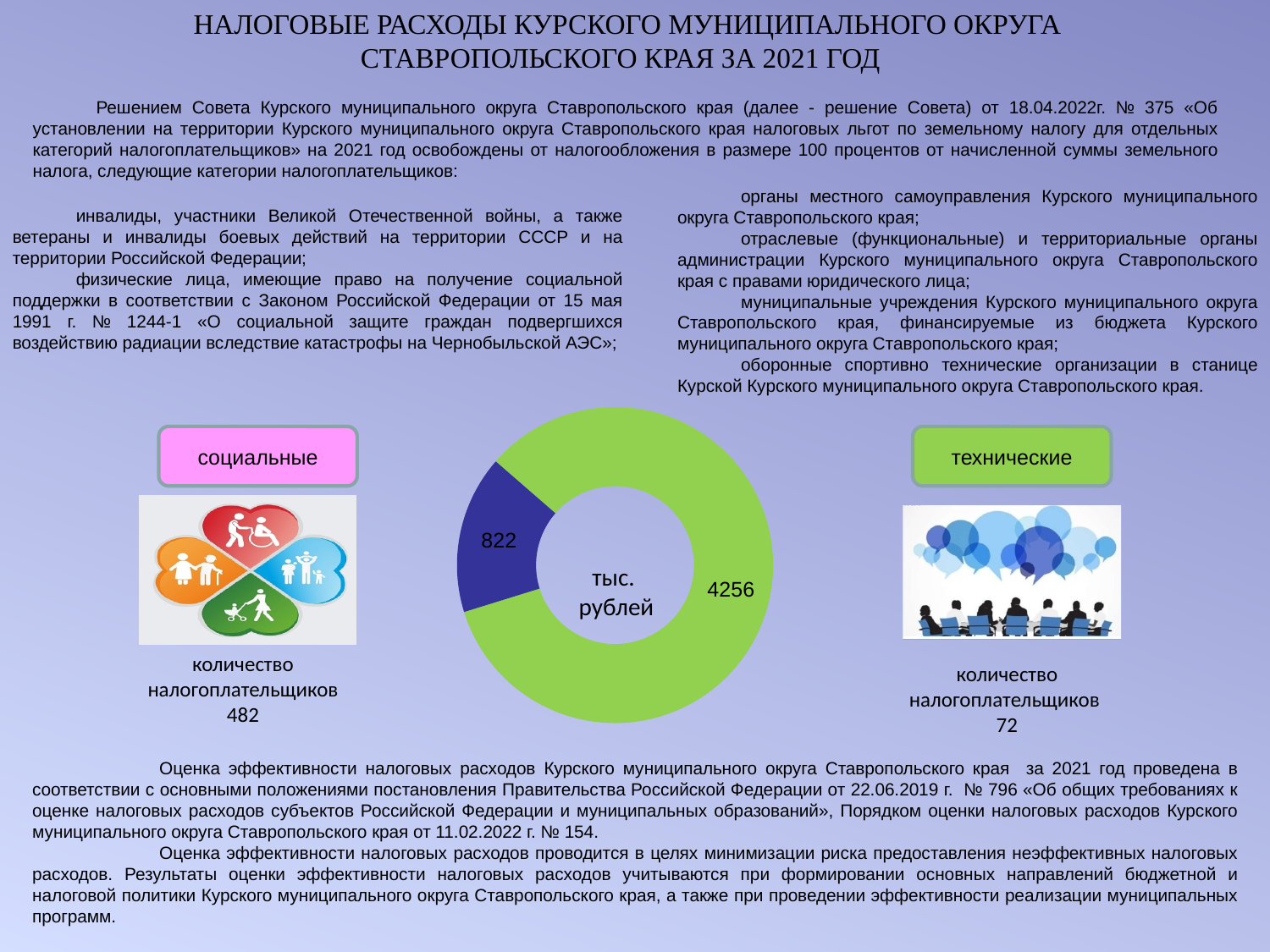
What kind of chart is shown in the middle of the slide? Donut (pie) chart Which slice of the donut chart has the smallest value? The dark blue slice (822) Which slice of the donut chart has the largest value? The green slice (4256) How many slices does the donut chart have? 2 What is the difference between the two values shown on the donut chart, 4256 and 822? 3434 What share of the donut chart total does the slice labelled 822 represent? 16.2% What is the total of the two values shown on the donut chart? 5078 Which is larger on the donut chart: the green slice or the dark blue slice? The green slice What unit is written in the centre of the donut chart? тыс. рублей What value is printed on the green slice of the donut chart? 4256 Is the value of the dark blue slice of the donut chart greater or less than 1000? less What value is printed on the dark blue slice of the donut chart? 822